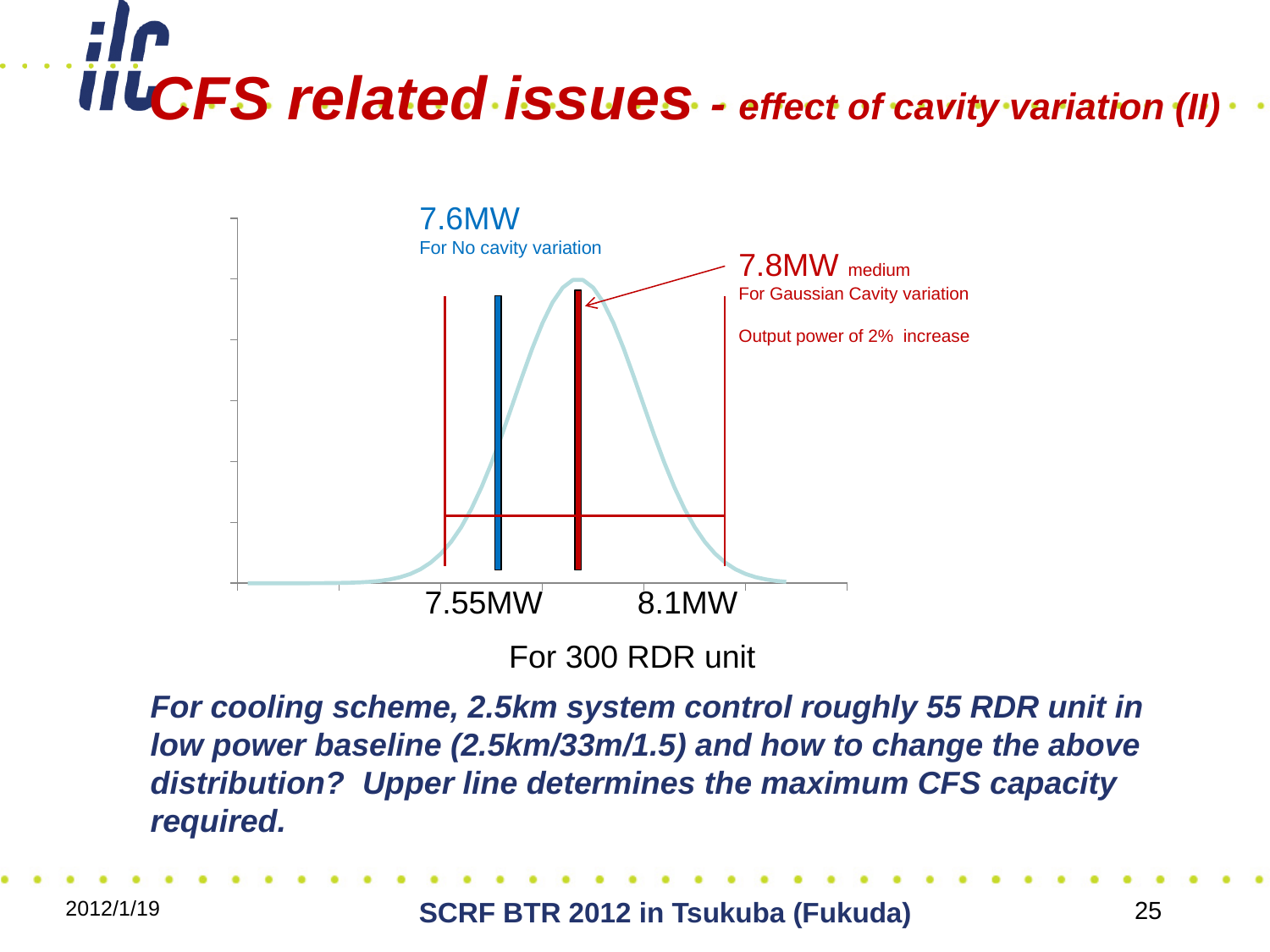
What kind of chart is shown on the slide? Line chart (Gaussian distribution curve) What is the difference between the upper (8.1MW) and lower (7.55MW) power values marked on the distribution? 0.55MW What output power is shown for no cavity variation? 7.6MW What is the medium output power shown for Gaussian cavity variation? 7.8MW What is the lower power value labelled on the x axis of the distribution? 7.55MW What colour is the vertical bar marking the no cavity variation value? Blue What is the difference between the Gaussian cavity variation medium value and the no cavity variation value? 0.2MW How many RDR units does the distribution chart refer to? 300 What is the upper power value labelled on the x axis of the distribution? 8.1MW What percentage increase in output power is noted for the Gaussian cavity variation case? 2% Which is larger: the power for no cavity variation or the medium power for Gaussian cavity variation? Gaussian cavity variation (7.8MW)